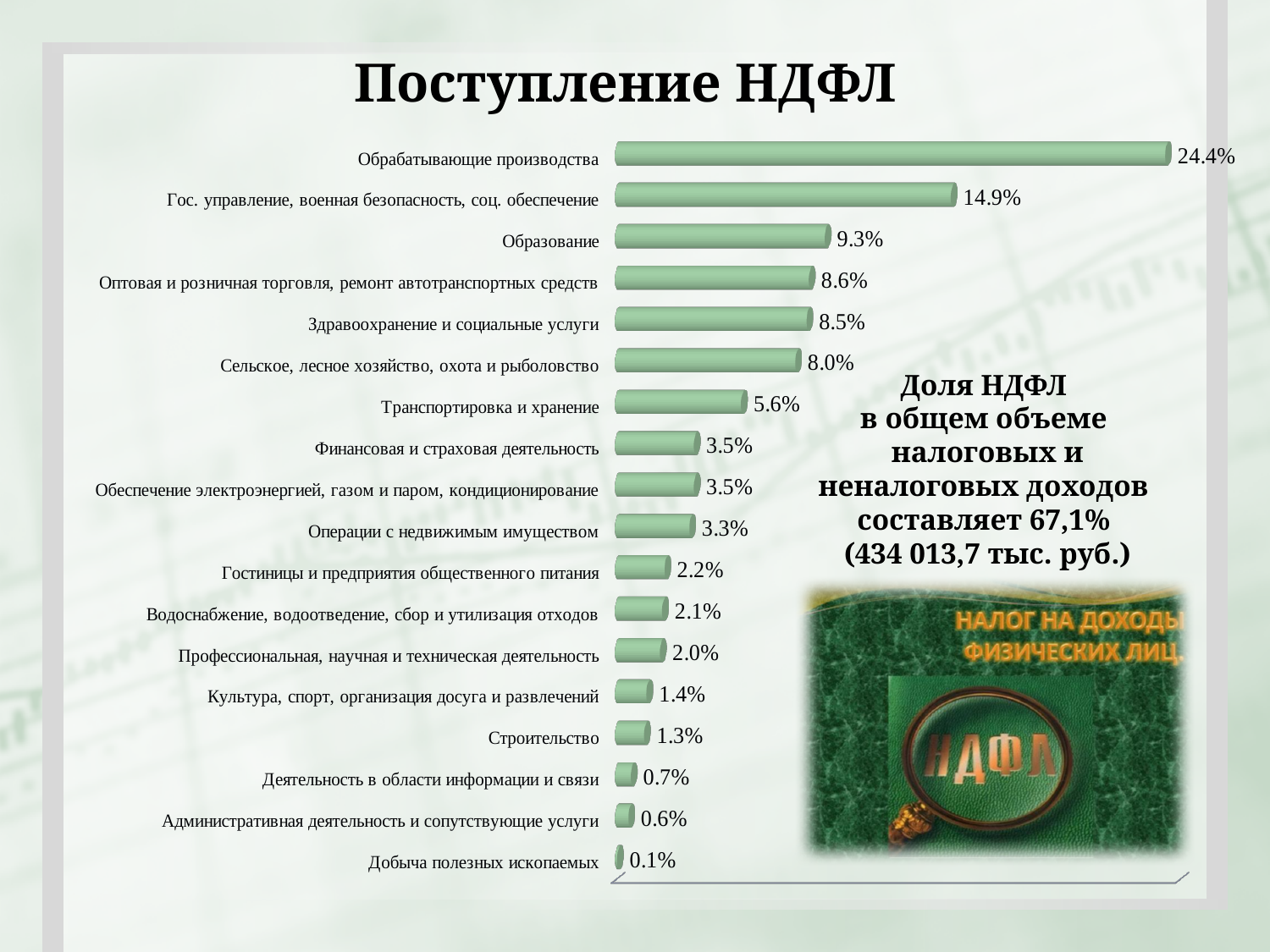
What is the difference between the values for Обрабатывающие производства and Гос. управление, военная безопасность, соц. обеспечение? 9.5% Which is larger: the value for Сельское, лесное хозяйство, охота и рыболовство or the value for Транспортировка и хранение? Сельское, лесное хозяйство, охота и рыболовство What is the value for Обрабатывающие производства? 24.4% Which category has the highest value? Обрабатывающие производства What is the value for Образование? 9.3% What is the value for Транспортировка и хранение? 5.6% What is the difference between the values for Образование and Здравоохранение и социальные услуги? 0.8% What is the title of the slide? Поступление НДФЛ What is the value for Строительство? 1.3% Which category has the lowest value? Добыча полезных ископаемых What kind of chart is shown on the slide? Bar chart How many categories are shown in the chart? 18